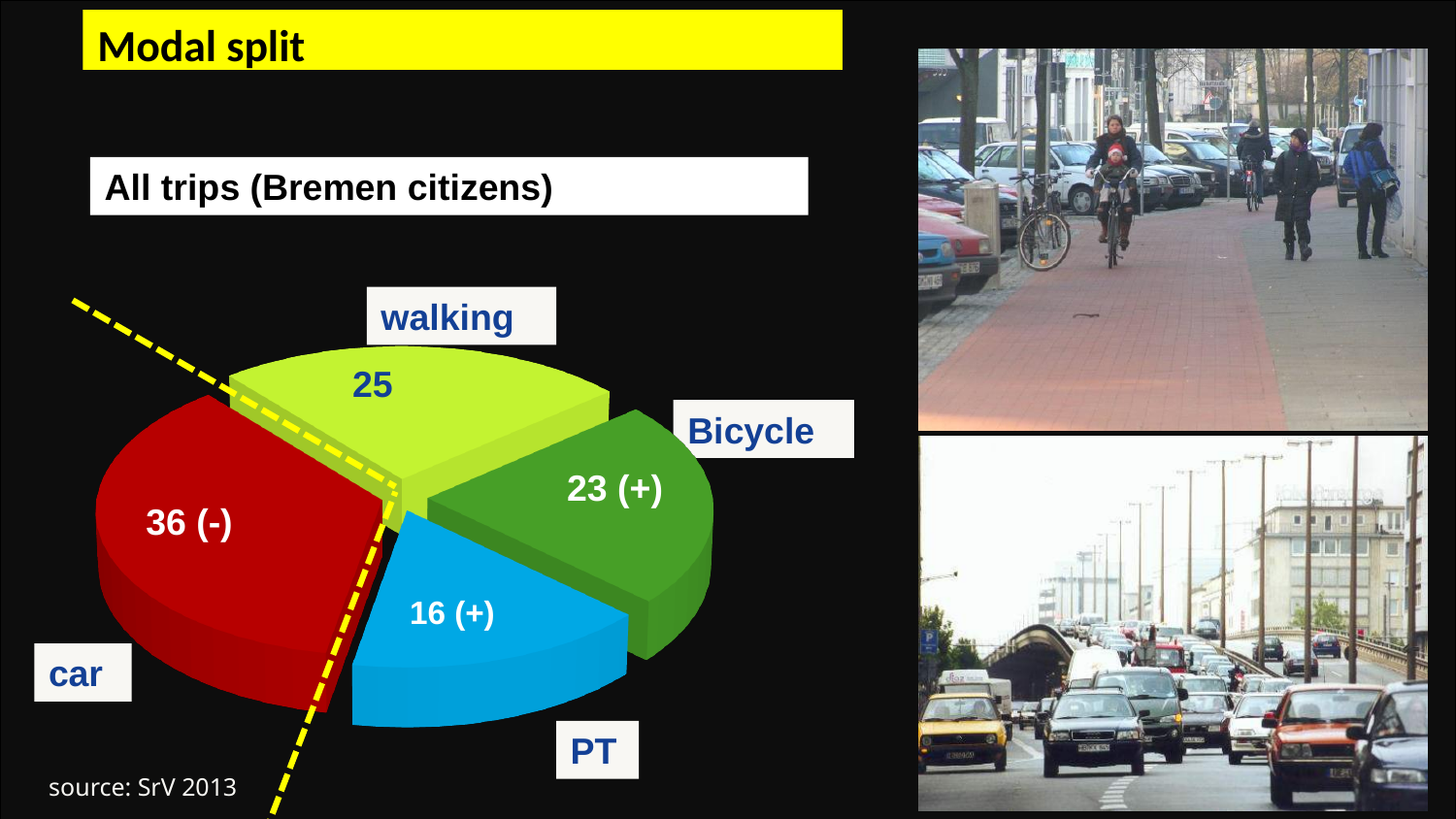
What type of chart is shown on the slide? pie chart What is the value shown for the walking slice in the pie chart? 25 Which mode has the largest slice in the pie chart? car What is the title shown above the pie chart? All trips (Bremen citizens) What is the difference between the Bicycle value and the PT value in the pie chart? 7 What is the value shown for the PT slice in the pie chart? 16 (+) Which mode has the smallest slice in the pie chart? PT Which is larger in the pie chart, the walking value or the Bicycle value? walking How many slices does the pie chart have? 4 What is the value shown for the Bicycle slice in the pie chart? 23 (+) What is the difference between the car value and the walking value in the pie chart? 11 What is the value shown for the car slice in the pie chart? 36 (-)